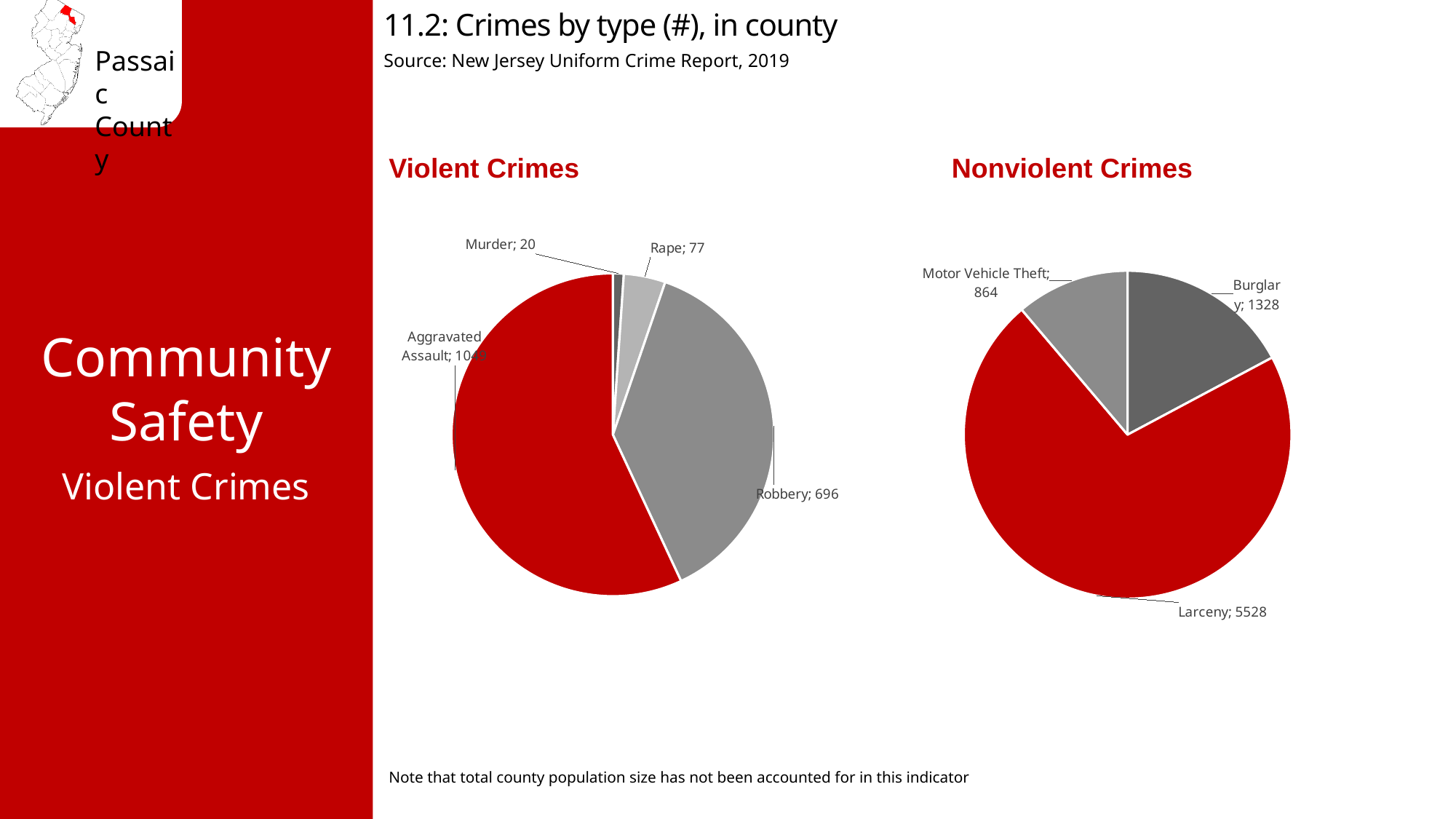
In the Nonviolent Crimes pie chart, which crime type has the largest slice? Larceny How many categories does the Nonviolent Crimes pie chart show? 3 In the Violent Crimes pie chart, which crime type has the smallest slice? Murder In the Violent Crimes pie chart, how many murders are shown? 20 In the Violent Crimes pie chart, what is the value for Robbery? 696 In the Violent Crimes pie chart, which crime type has the largest slice? Aggravated Assault In the Nonviolent Crimes pie chart, what is the value for Burglary? 1328 In the Violent Crimes pie chart, what is the value for Rape? 77 In the Nonviolent Crimes pie chart, what is the value for Motor Vehicle Theft? 864 In the Nonviolent Crimes pie chart, how many more burglaries than motor vehicle thefts are there? 464 In the Nonviolent Crimes pie chart, what is the value for Larceny? 5528 In the Violent Crimes pie chart, which is larger, Robbery or Rape? Robbery